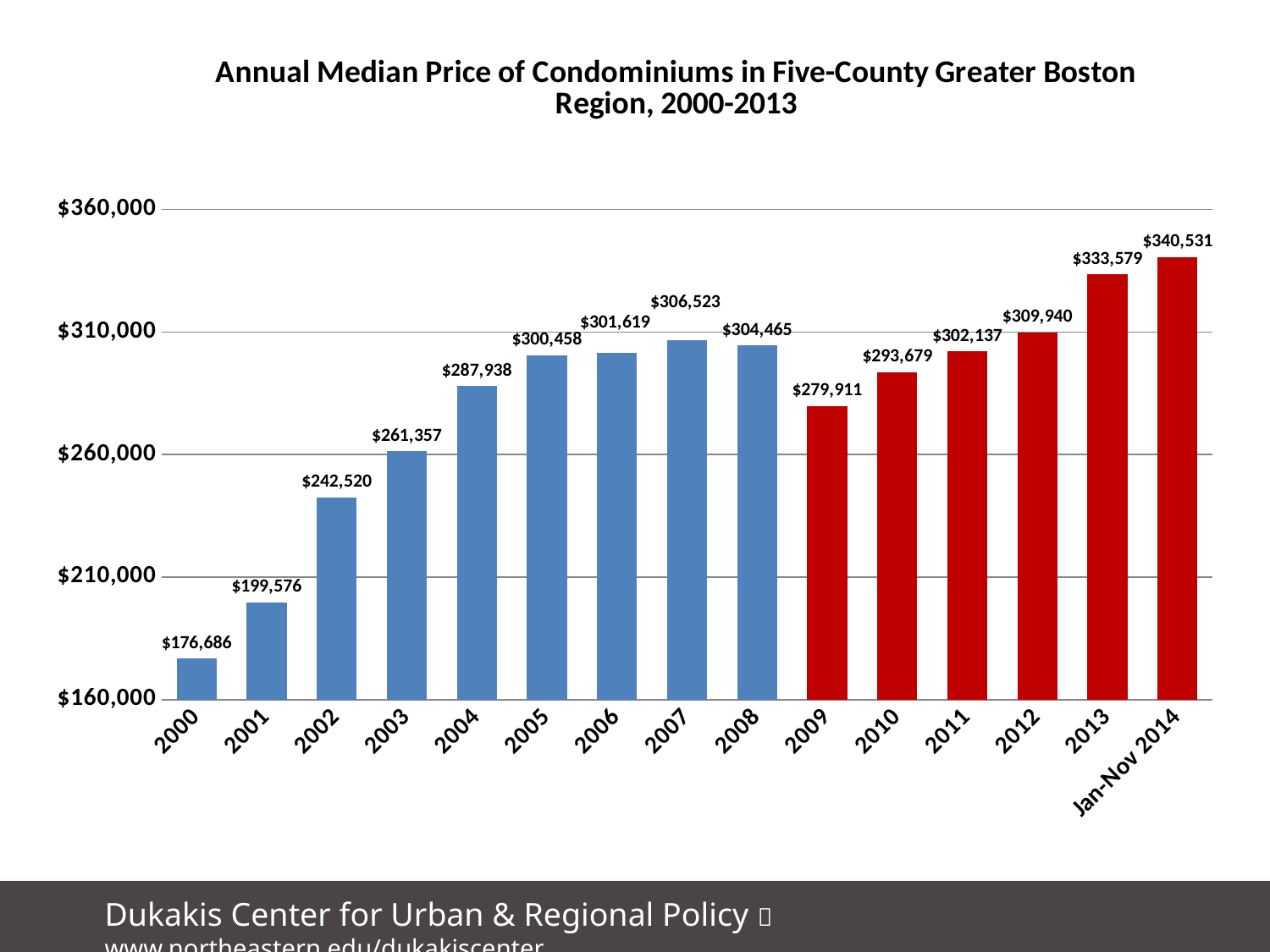
What is the difference between the median price in 2008 and in 2009? $24,554 Which year has a higher median condominium price, 2007 or 2008? 2007 What type of chart is shown on the slide? Bar chart Which year has the lowest median condominium price? 2000 What colour are the bars for 2009 through Jan-Nov 2014? Red What is the median condominium price shown for 2013? $333,579 What is the difference between the median price in 2013 and in 2012? $23,639 What is the median condominium price shown for 2007? $306,523 What is the median condominium price shown for Jan-Nov 2014? $340,531 Which period has the highest median condominium price? Jan-Nov 2014 What is the median condominium price shown for 2000? $176,686 How many bars are plotted on the chart? 15